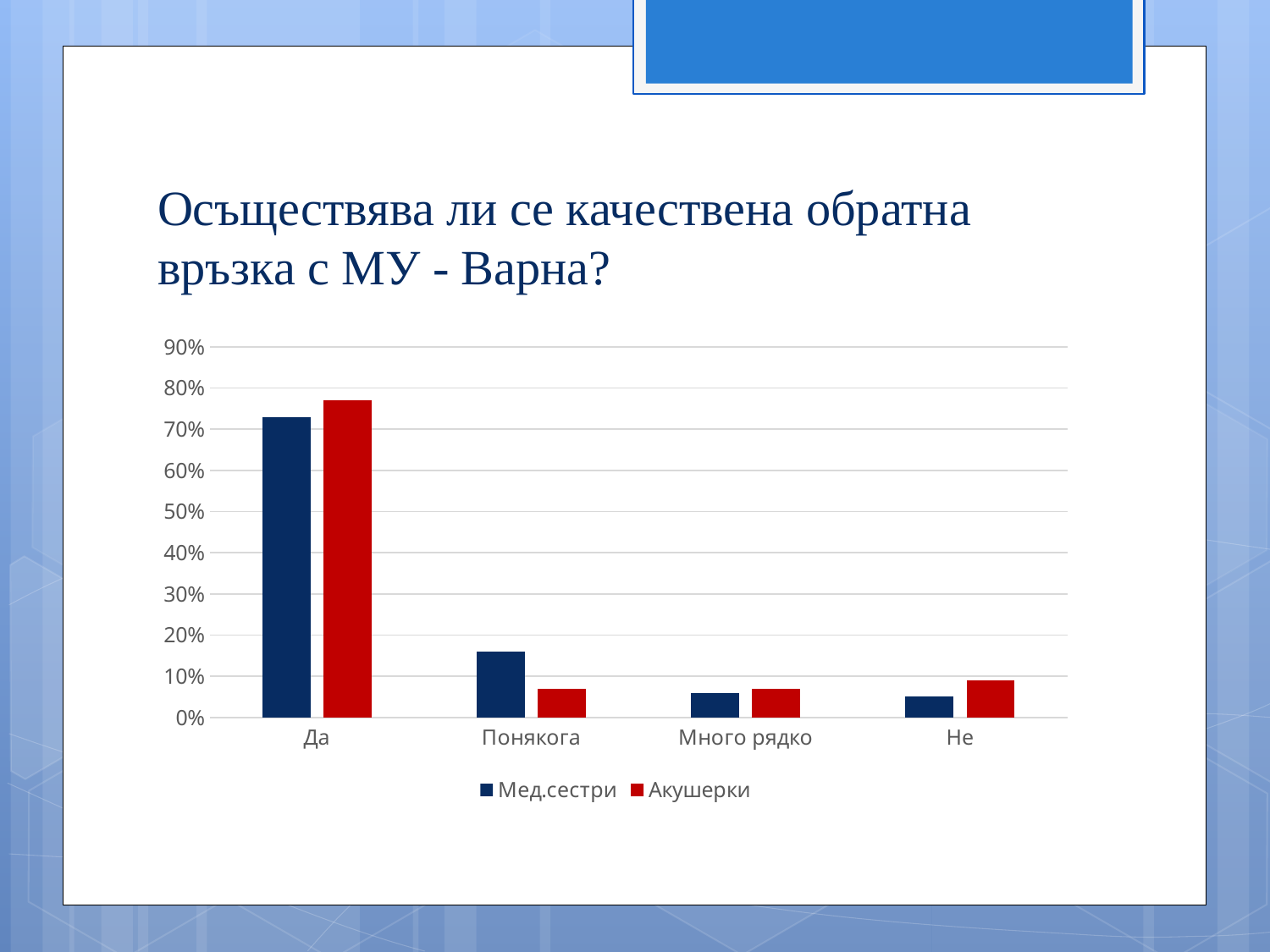
For the category Понякога, which series has the larger value, Мед.сестри or Акушерки? Мед.сестри Is the value for Мед.сестри in the category Да greater or less than 60%? greater How many response categories are shown on the x axis? 4 Which category has the highest value for Акушерки? Да For the category Не, which series has the larger value, Мед.сестри or Акушерки? Акушерки What kind of chart is shown on the slide? bar chart For the category Да, which series has the larger value, Мед.сестри or Акушерки? Акушерки How many series does the legend list? 2 Is the value for Мед.сестри in the category Понякога greater or less than 20%? less Which category has the highest value for Мед.сестри? Да Is the value for Акушерки in the category Да greater or less than 70%? greater What colour are the bars for the series Акушерки? red